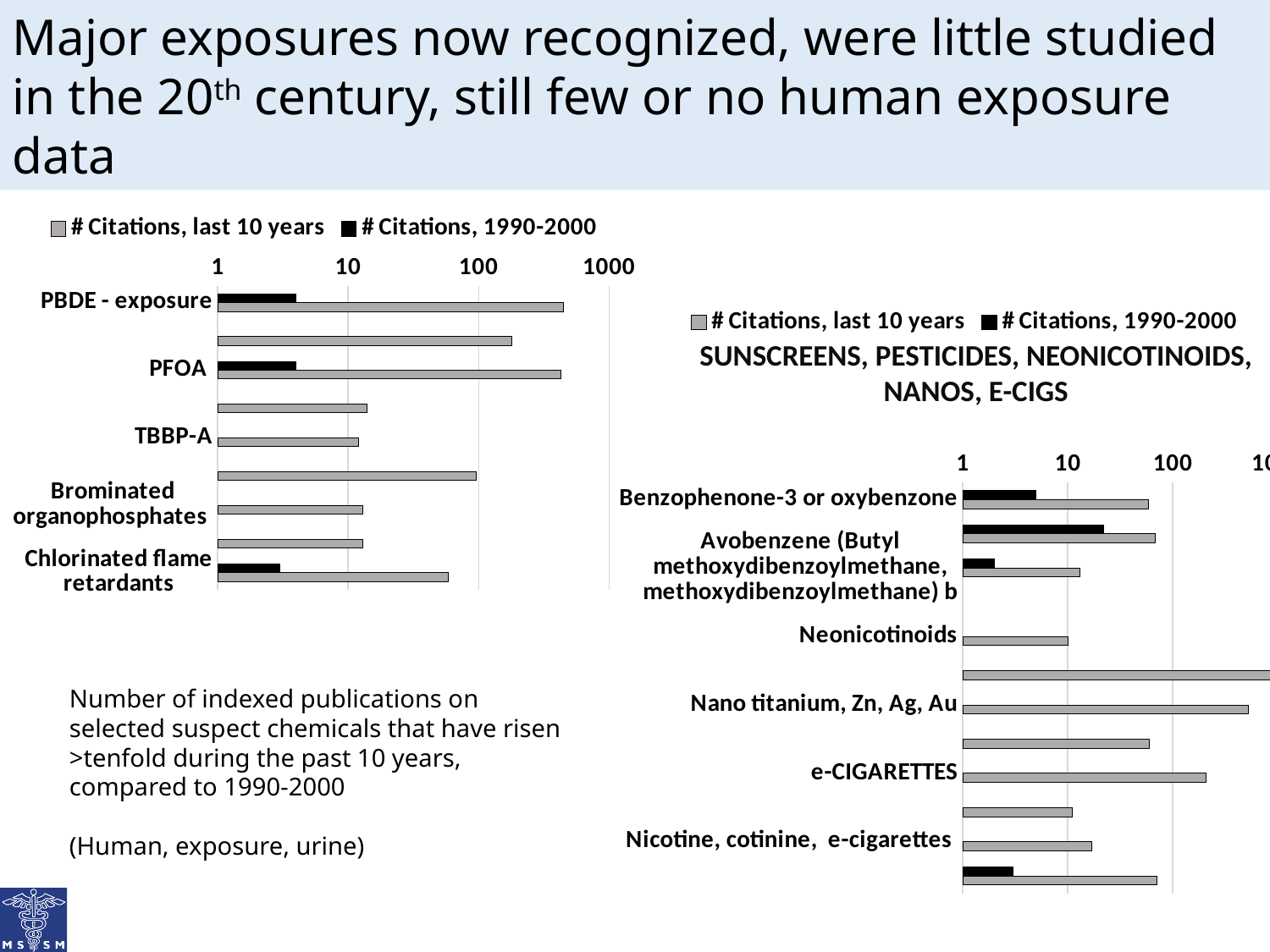
What is the title of the right chart? SUNSCREENS, PESTICIDES, NEONICOTINOIDS, NANOS, E-CIGS On the left chart, is the value of '# Citations, 1990-2000' for Chlorinated flame retardants greater or less than 10? less How many series does the legend of the right chart list? 2 On the right chart, is the value of '# Citations, last 10 years' for Benzophenone-3 or oxybenzone greater or less than 10? greater On the left chart, is the value of '# Citations, last 10 years' for PBDE - exposure greater or less than 100? greater What is the highest tick label shown on the x axis of the left chart? 1000 What kind of chart is the left chart on the slide? bar chart How many categories are shown on the left chart? 9